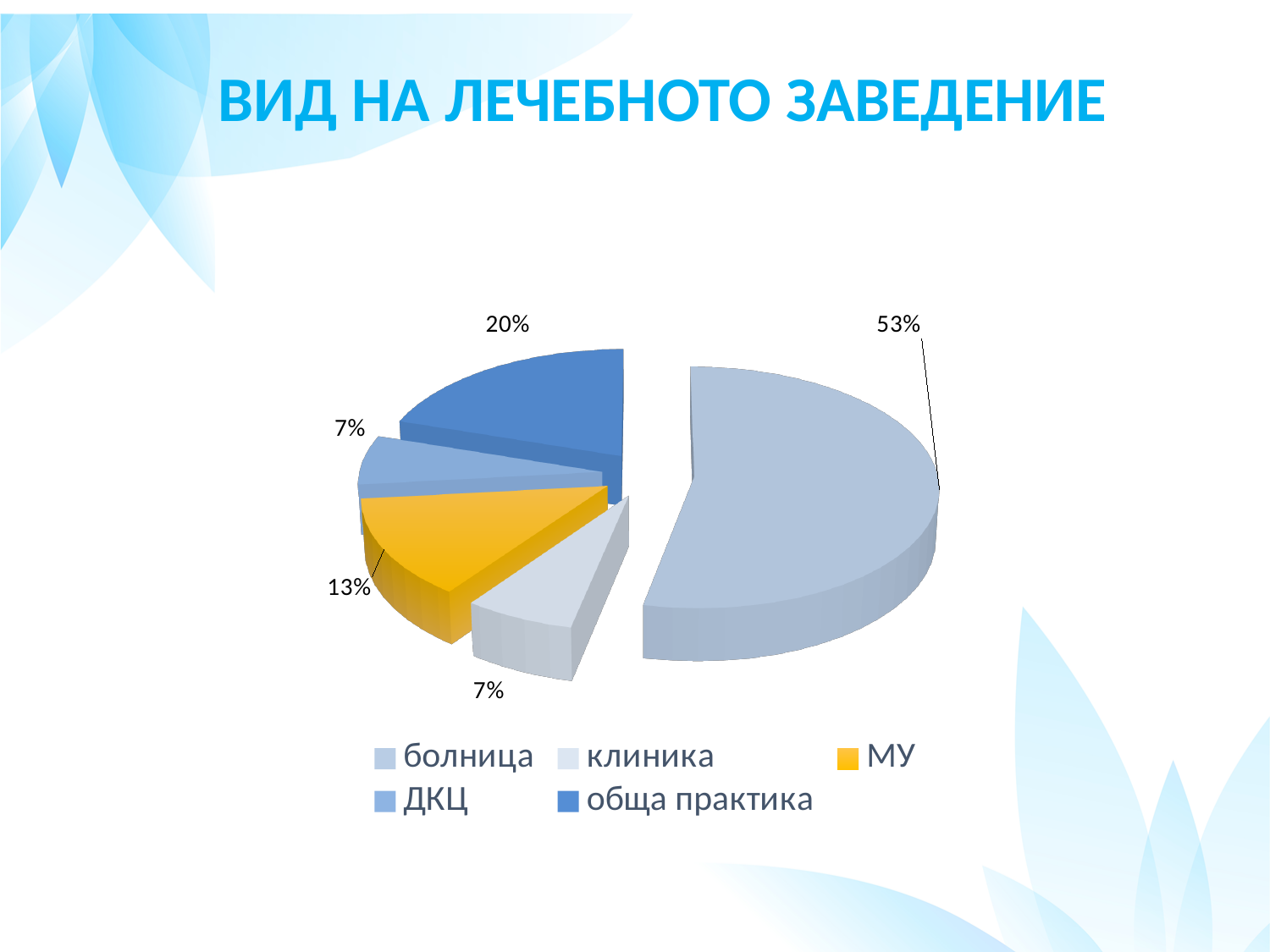
How many categories does the legend list? 5 What share of the pie does ДКЦ have? 7% What share of the pie does клиника have? 7% What is the title of the chart? ВИД НА ЛЕЧЕБНОТО ЗАВЕДЕНИЕ What share of the pie does обща практика have? 20% Which is larger, the share for МУ or the share for ДКЦ? МУ Which category is shown in yellow? МУ What is the difference in percentage points between болница and обща практика? 33 Which category has the largest slice of the pie? болница What type of chart is shown on the slide? pie chart